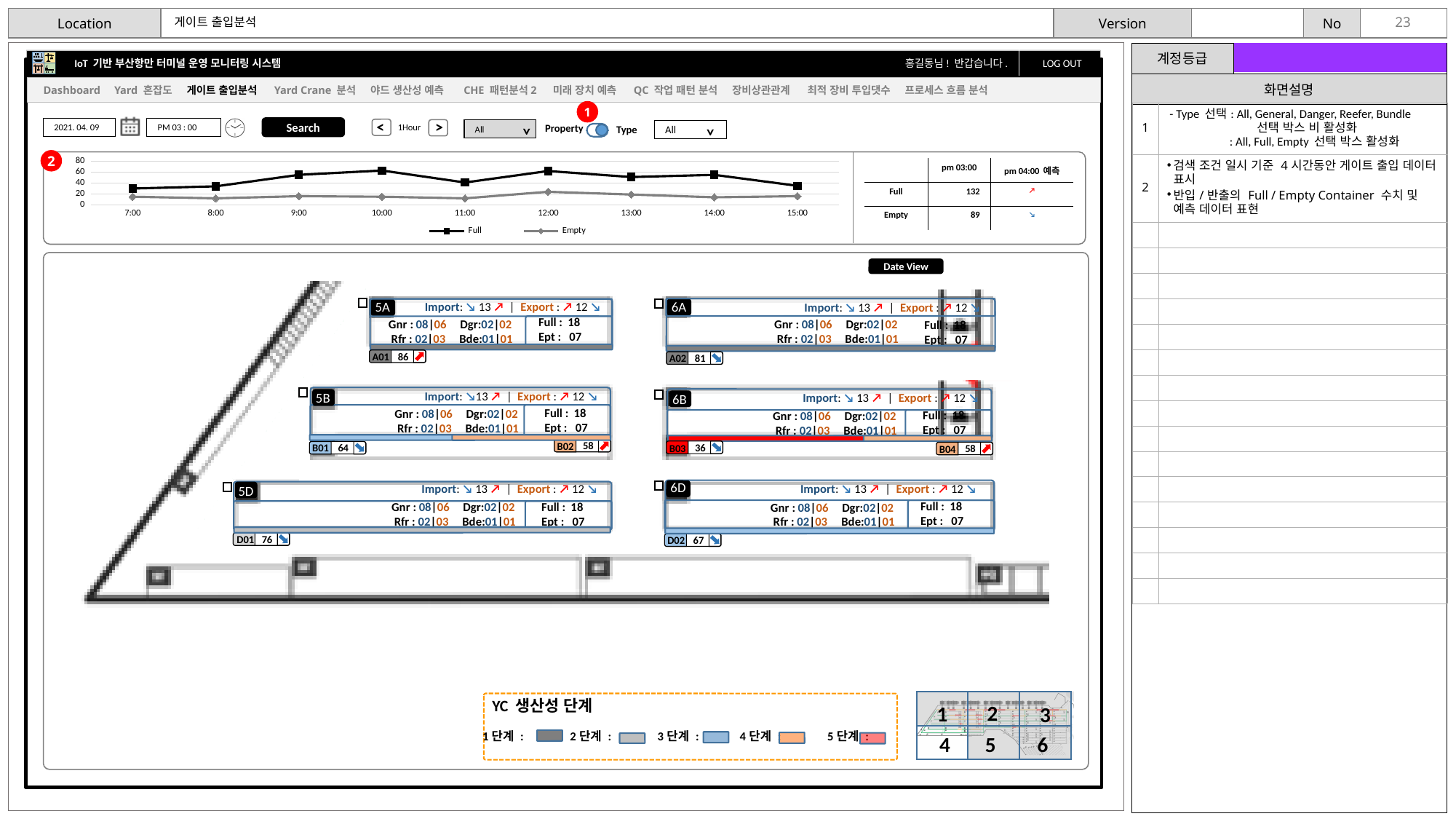
Is the value of the Full series at 9:00 greater or less than 40? greater How many series does the legend of the line chart list? 2 What are the two series named in the line chart's legend? Full and Empty Does the Full series rise or fall from 7:00 to 10:00? rise At 10:00, which series has the larger value, Full or Empty? Full Is the value of the Full series at 10:00 greater or less than 40? greater What kind of chart is shown at the top of the screen mock-up? line chart Is the value of the Full series at 7:00 greater or less than 40? less How many time points are plotted along the x axis of the line chart? 9 Does the Full series rise or fall from 14:00 to 15:00? fall For the Full series, which is larger: the value at 10:00 or the value at 11:00? 10:00